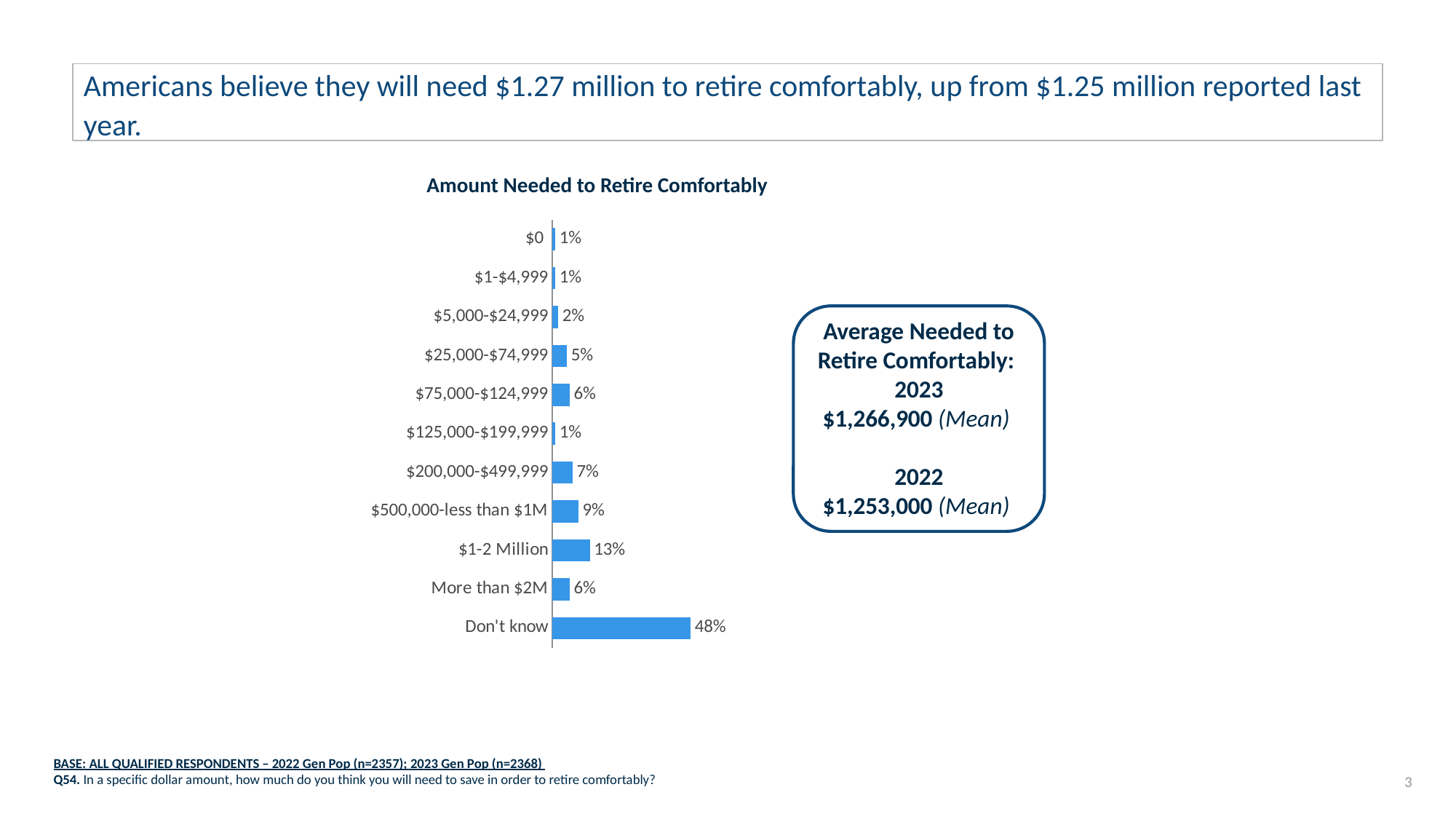
What type of chart is shown on the slide? Bar chart What is the value for the $200,000-$499,999 category? 7% What is the value for "Don't know" in the Amount Needed to Retire Comfortably chart? 48% Which is larger: the value for $75,000-$124,999 or the value for $125,000-$199,999? $75,000-$124,999 What is the title of the chart? Amount Needed to Retire Comfortably What is the difference between the $500,000-less than $1M value and the $25,000-$74,999 value? 4% Which is larger: the value for $1-2 Million or the value for More than $2M? $1-2 Million What is the difference between the "Don't know" value and the $1-2 Million value? 35% How many categories are shown in the chart? 11 Which category has the highest value in the chart? Don't know What percentage of respondents said they need $1-2 Million to retire comfortably? 13% What is the value for the $500,000-less than $1M category? 9%